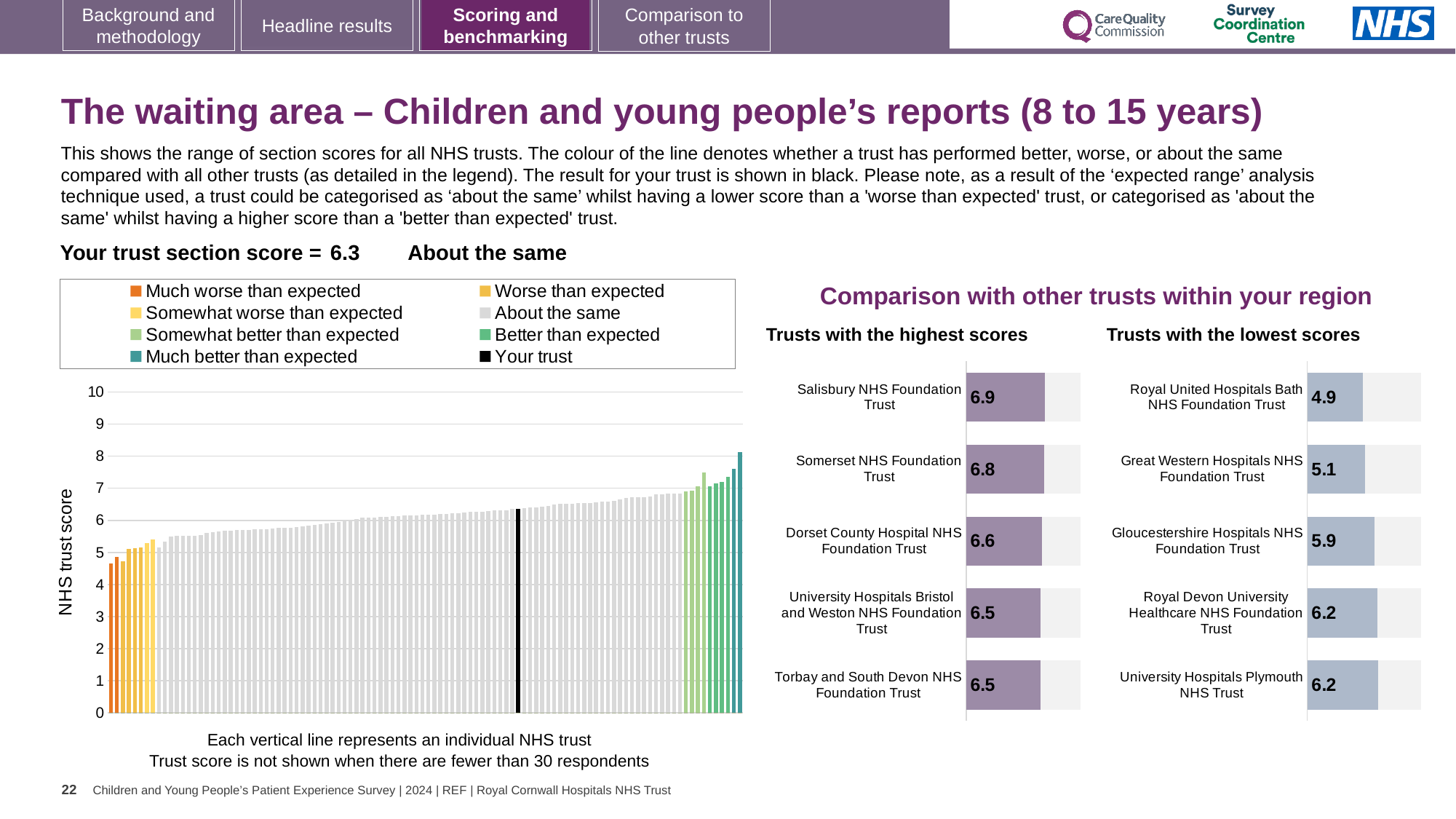
In the 'Trusts with the highest scores' chart, which trust has the highest score? Salisbury NHS Foundation Trust In the 'Trusts with the lowest scores' chart, what is the difference between the scores of Gloucestershire Hospitals NHS Foundation Trust and Great Western Hospitals NHS Foundation Trust? 0.8 In the 'Trusts with the lowest scores' chart, which trust has the lowest score? Royal United Hospitals Bath NHS Foundation Trust In the 'Trusts with the lowest scores' chart, what is the score for University Hospitals Plymouth NHS Trust? 6.2 In the NHS trust score chart on the left, do the trust scores rise or fall from left to right? Rise In the NHS trust score chart on the left, what kind of chart is it? Bar chart In the NHS trust score chart on the left, how many entries does the legend list? 8 In the 'Trusts with the lowest scores' chart, which has the larger score: Great Western Hospitals NHS Foundation Trust or Gloucestershire Hospitals NHS Foundation Trust? Gloucestershire Hospitals NHS Foundation Trust In the 'Trusts with the highest scores' chart, how many trusts are shown? 5 In the 'Trusts with the lowest scores' chart, what is the score for Royal United Hospitals Bath NHS Foundation Trust? 4.9 In the 'Trusts with the highest scores' chart, what is the difference between the scores of Salisbury NHS Foundation Trust and Dorset County Hospital NHS Foundation Trust? 0.3 In the 'Trusts with the highest scores' chart, what is the score for Salisbury NHS Foundation Trust? 6.9